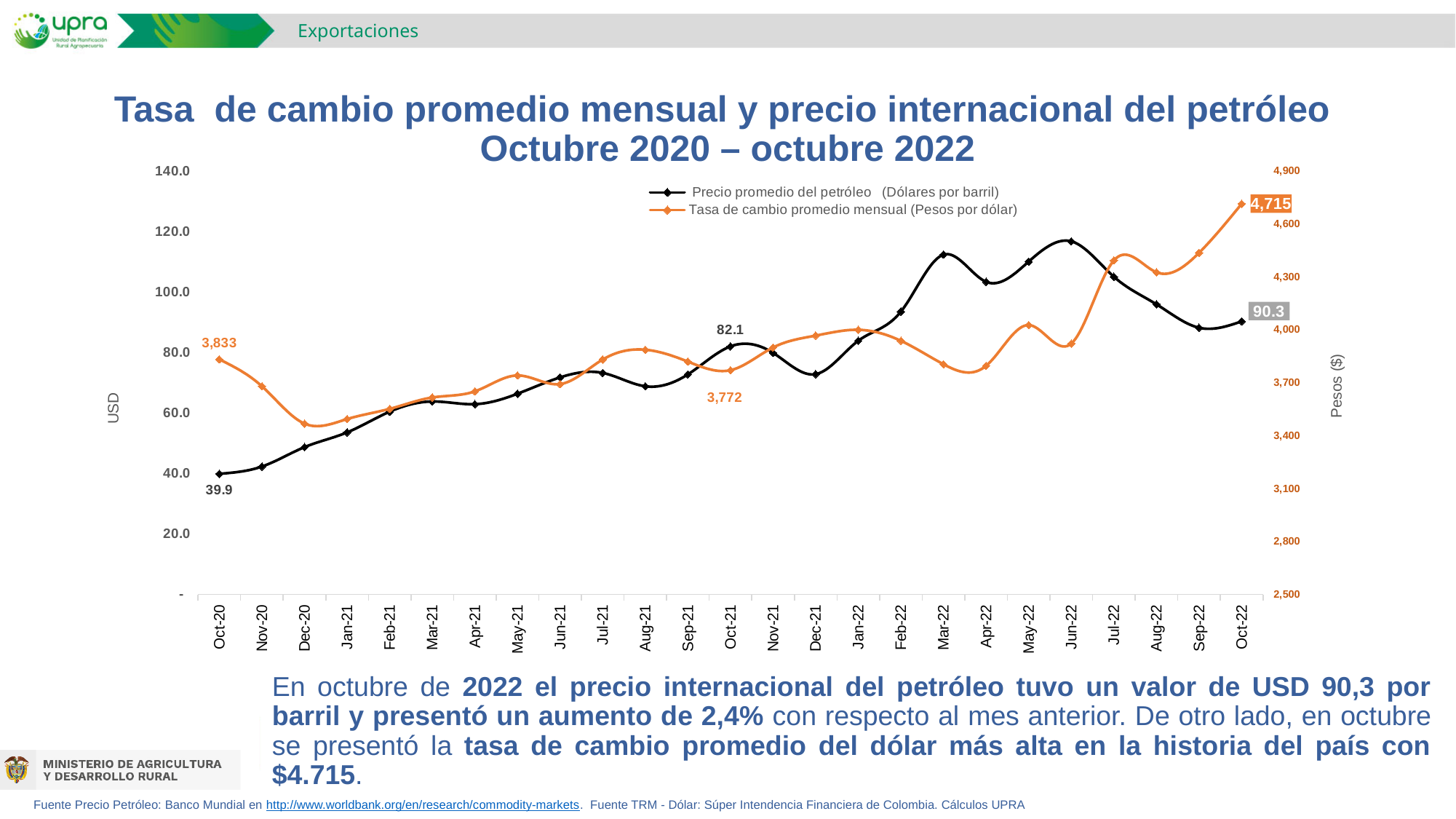
Is the Precio promedio del petróleo value for Mar-22 greater or less than 100? greater What is the difference between the Tasa de cambio promedio mensual values for Oct-22 and Oct-20? 882 In which month is the Precio promedio del petróleo series at its lowest? Oct-20 What is the value of the Precio promedio del petróleo series for Oct-20? 39.9 What is the difference between the Precio promedio del petróleo values for Oct-22 and Oct-21? 8.2 Which is larger for the Tasa de cambio promedio mensual series: Oct-20 or Oct-21? Oct-20 Is the Tasa de cambio promedio mensual value for Dec-20 greater or less than 3,700? less In which month is the Tasa de cambio promedio mensual series at its highest? Oct-22 What is the value of the Tasa de cambio promedio mensual series for Oct-22? 4,715 How many series does the legend list? 2 What is the value of the Tasa de cambio promedio mensual series for Oct-21? 3,772 What is the value of the Precio promedio del petróleo series for Oct-22? 90.3